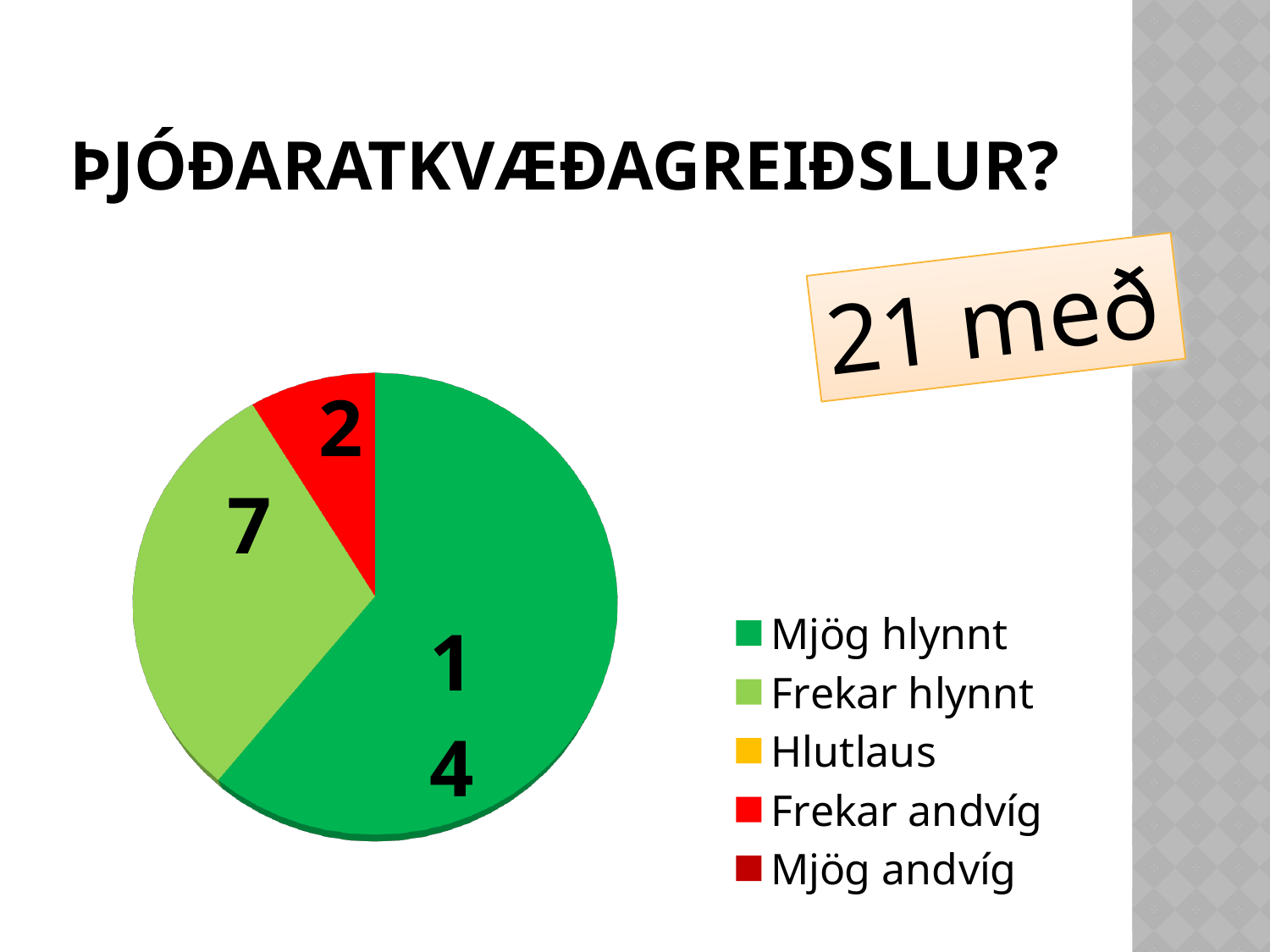
What is the difference between the Frekar hlynnt value and the Frekar andvíg value? 5 Which category has the largest slice in the pie chart? Mjög hlynnt How many slices with data labels are visible in the pie chart? 3 What is the total of the three labeled values in the pie chart? 23 Which is larger, the Frekar hlynnt slice or the Frekar andvíg slice? Frekar hlynnt How many entries does the legend of the pie chart list? 5 What kind of chart is shown on the slide? pie chart What is the difference between the Mjög hlynnt value and the Frekar hlynnt value? 7 What value is shown for the Mjög hlynnt slice of the pie chart? 14 What value is shown for the Frekar andvíg slice of the pie chart? 2 What value is shown for the Frekar hlynnt slice of the pie chart? 7 Which of the slices visible in the pie chart is the smallest? Frekar andvíg